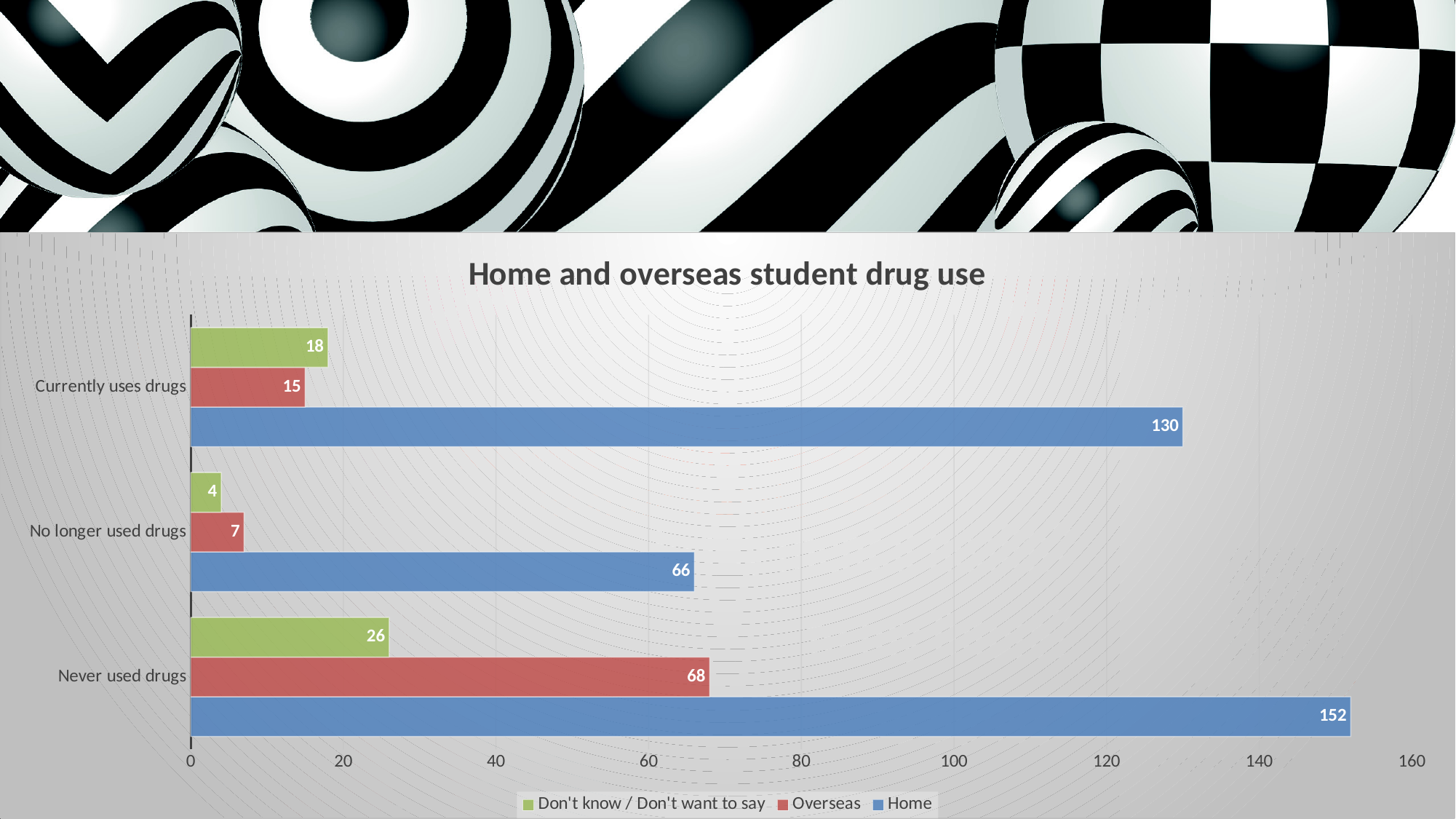
What kind of chart is shown on the slide? Bar chart Is the Home value for Currently uses drugs greater or less than 120? greater What is the Overseas value for Currently uses drugs? 15 How many series does the legend list? 3 What is the Home value for Never used drugs? 152 What is the title of the chart? Home and overseas student drug use What is the difference between the Home and Overseas values for Never used drugs? 84 Which is larger for Currently uses drugs: the Overseas value or the Don't know / Don't want to say value? Don't know / Don't want to say Which category has the lowest Overseas value? No longer used drugs Which category has the highest Home value? Never used drugs How many categories are shown on the chart? 3 What is the Don't know / Don't want to say value for No longer used drugs? 4